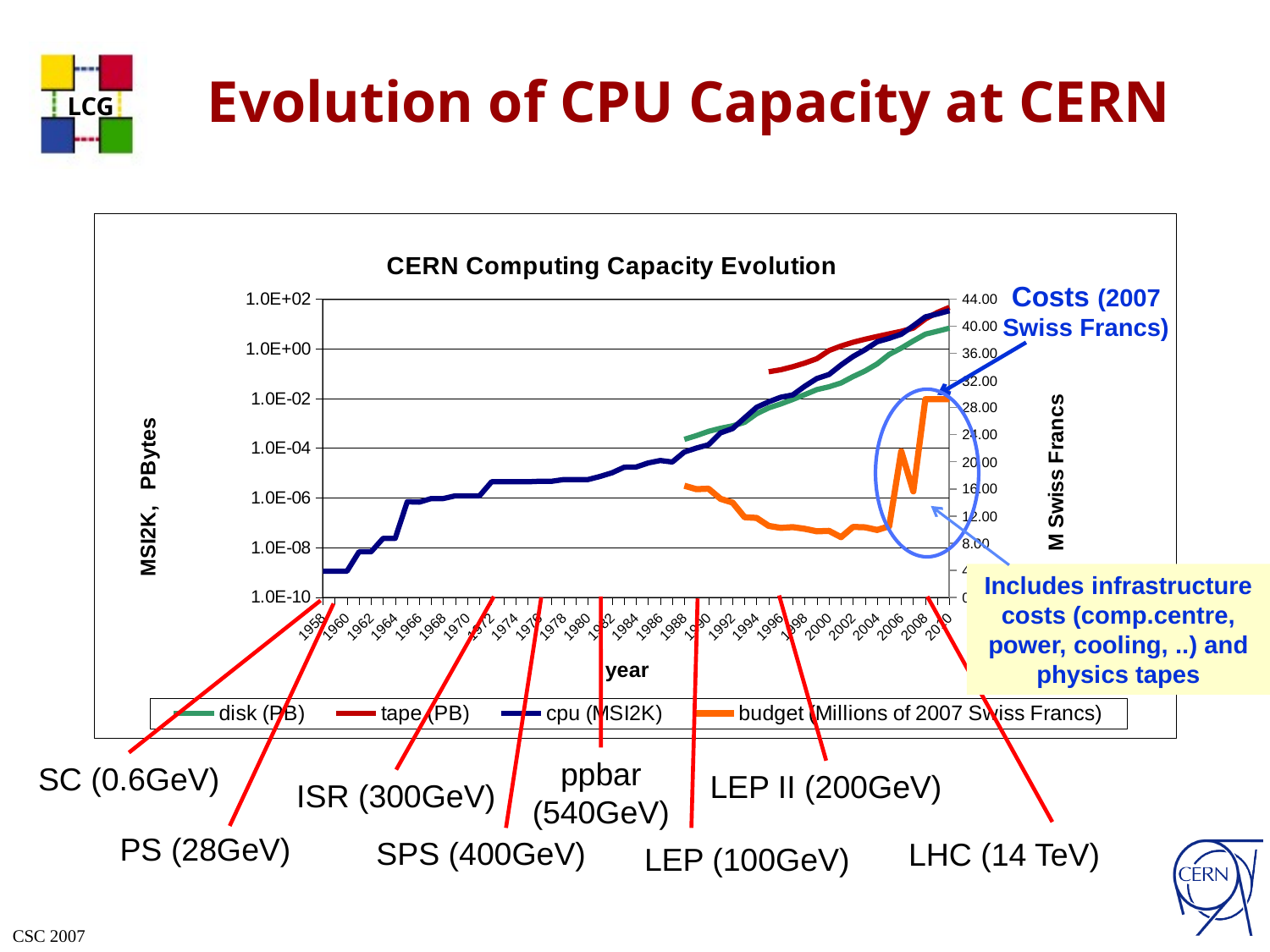
In 2010, which series has the higher value: cpu (MSI2K) or disk (PB)? cpu (MSI2K) Is the budget value in 2004 greater or less than 12.00 M Swiss Francs? less In 2000, which series has the higher value: tape (PB) or disk (PB)? tape (PB) Does the cpu (MSI2K) series rise or fall from 1958 to 2010? rise How many series does the legend of the chart list? 4 Is the budget value in 2008 greater or less than 24.00 M Swiss Francs? greater Is the cpu (MSI2K) value in 1958 greater or less than 1.0E-08? less Does the budget series rise or fall between 1988 and 2004? fall What is the title of the chart? CERN Computing Capacity Evolution What is the label of the x axis of the chart? year What kind of chart is shown on the slide? line chart